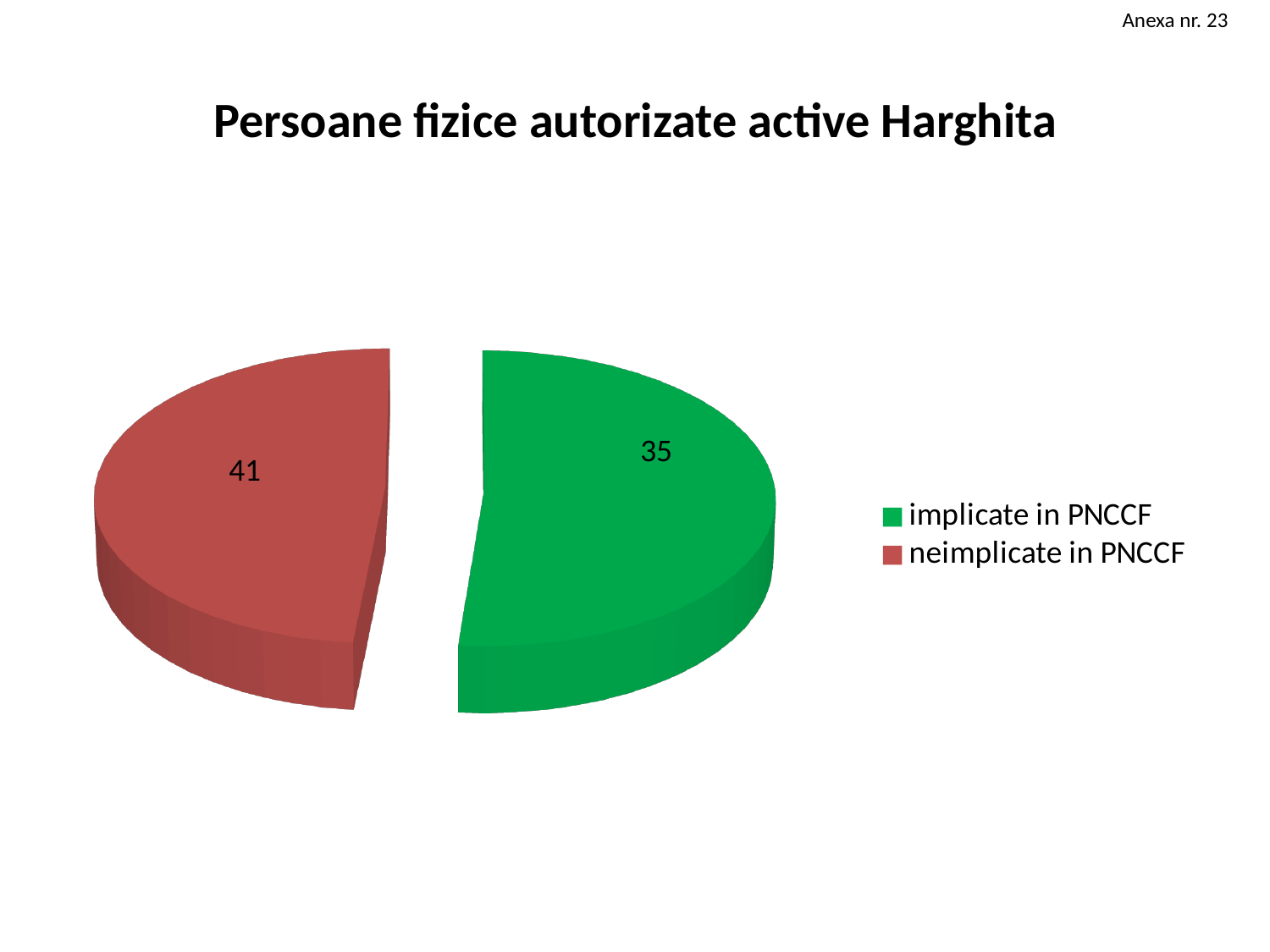
What is the total of the two slices in the pie chart? 76 What kind of chart is shown on the slide? pie chart How many slices does the pie chart have? 2 What is the value for "neimplicate in PNCCF"? 41 What is the title of the chart? Persoane fizice autorizate active Harghita What is the value for "implicate in PNCCF"? 35 What is the difference between the values for "neimplicate in PNCCF" and "implicate in PNCCF"? 6 How many entries does the legend list? 2 What colour is the slice for "implicate in PNCCF"? green Which is larger, the value for "implicate in PNCCF" or "neimplicate in PNCCF"? neimplicate in PNCCF